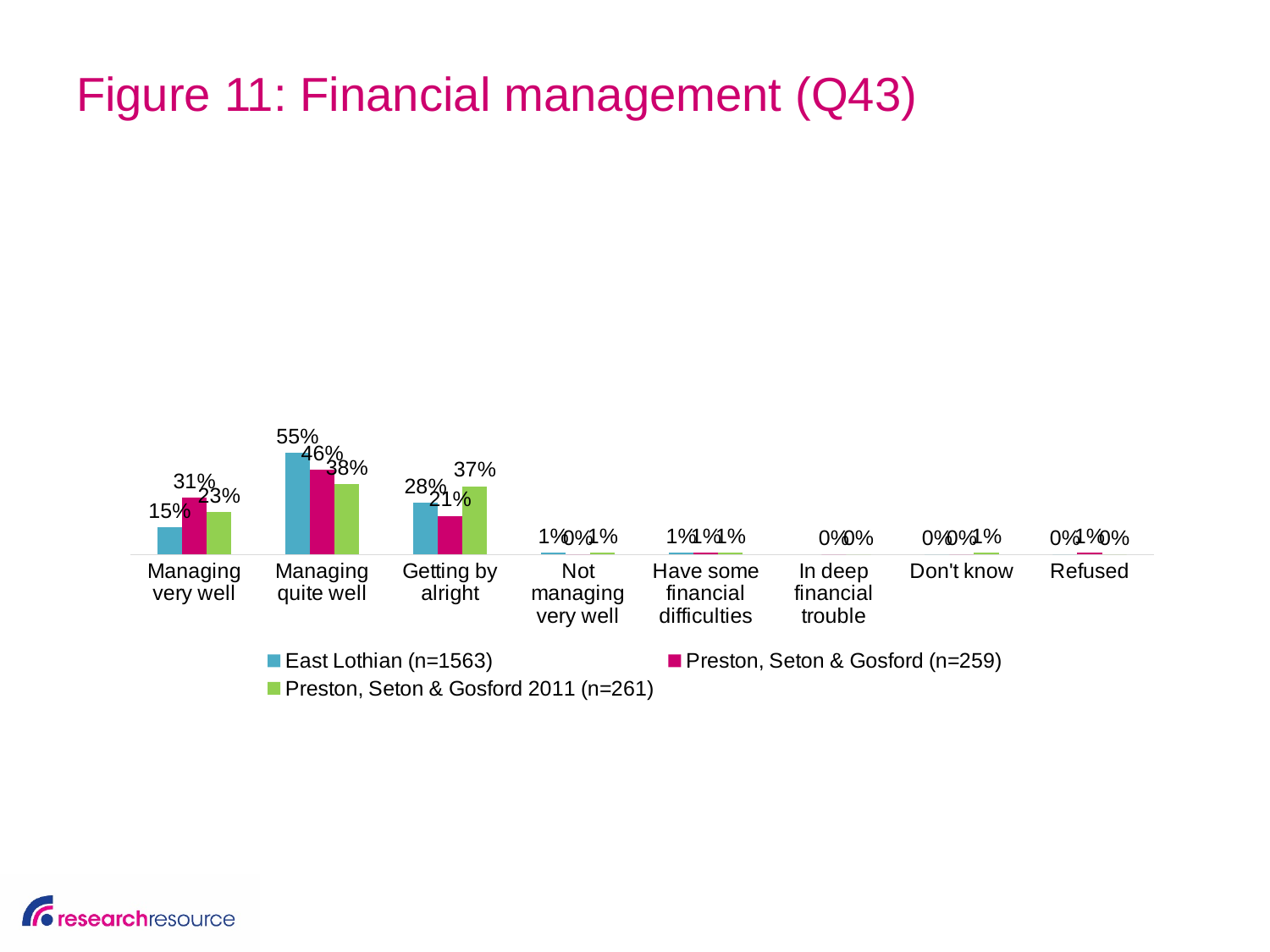
What is the value for East Lothian (n=1563) in the 'Getting by alright' category? 28% How many series does the legend list? 3 What is the value for Preston, Seton & Gosford 2011 (n=261) in the 'Getting by alright' category? 37% Which category has the highest value for East Lothian (n=1563)? Managing quite well What is the value for Preston, Seton & Gosford (n=259) in the 'Managing very well' category? 31% What is the value for East Lothian (n=1563) in the 'Managing quite well' category? 55% Which is larger in the 'Managing very well' category: East Lothian (n=1563) or Preston, Seton & Gosford 2011 (n=261)? Preston, Seton & Gosford 2011 (n=261) What is the difference between the East Lothian (n=1563) and Preston, Seton & Gosford (n=259) values for 'Managing quite well'? 9% How many categories are shown on the x axis? 8 What is the title of the chart? Figure 11: Financial management (Q43) What type of chart is shown on the slide? bar chart What is the difference between the Preston, Seton & Gosford 2011 (n=261) and Preston, Seton & Gosford (n=259) values for 'Getting by alright'? 16%